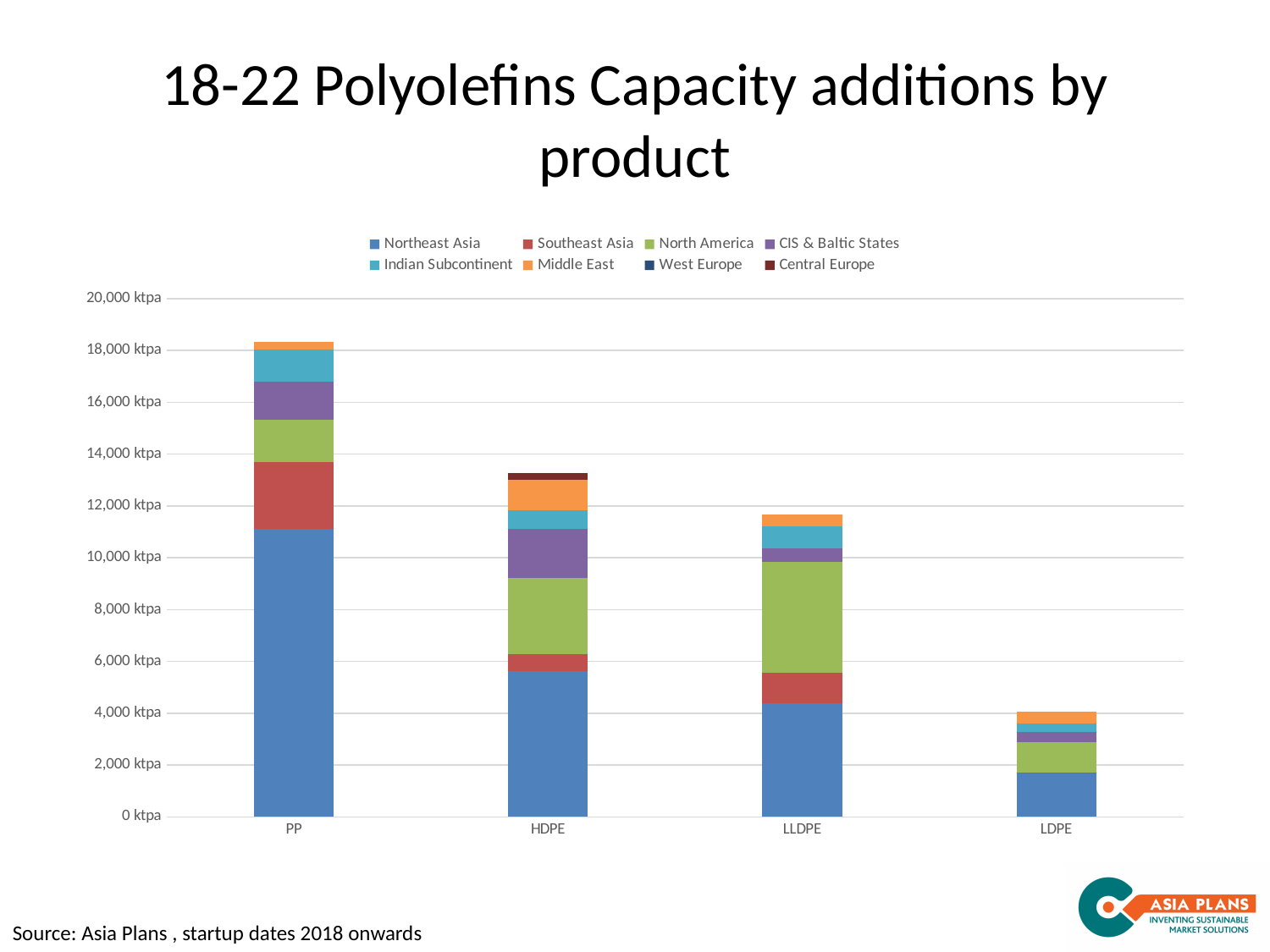
How many series does the legend list? 8 Is the total value for LDPE greater or less than 6,000 ktpa? less Which product has the highest total capacity addition? PP Is the total value for PP greater or less than 16,000 ktpa? greater What is the title of the chart on the slide? 18-22 Polyolefins Capacity additions by product Which product has the lowest total capacity addition? LDPE What kind of chart is shown on the slide? Stacked bar chart Which has the larger total capacity addition, HDPE or LLDPE? HDPE Is the Northeast Asia value for PP greater or less than 10,000 ktpa? greater Do the total bar heights rise or fall moving from PP to LDPE along the x axis? fall How many product categories are shown on the x axis? 4